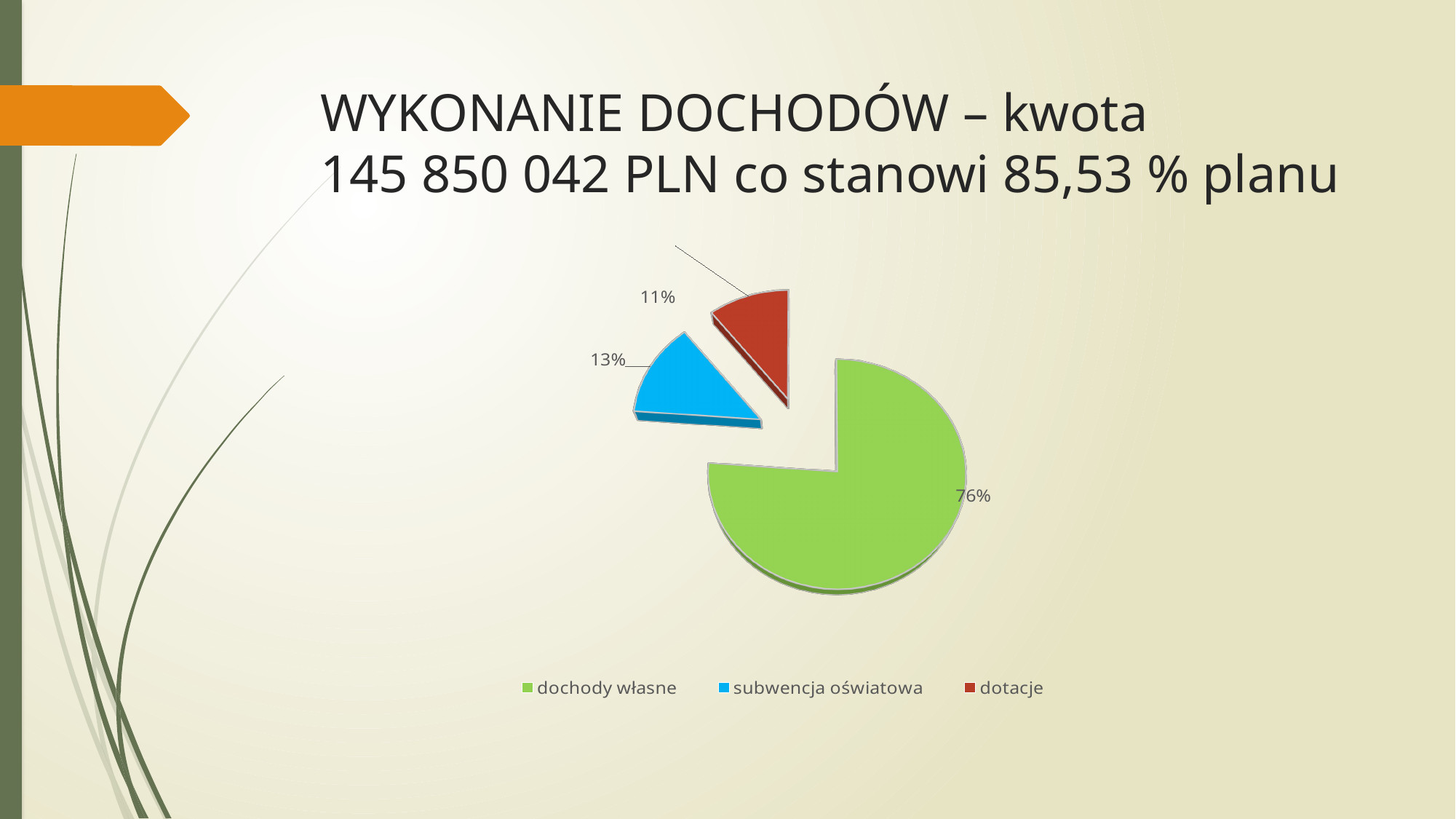
Which category has the largest slice of the pie? dochody własne How many entries does the legend list? 3 What share of the pie does dotacje represent? 11% What share of the pie does subwencja oświatowa represent? 13% Which category has the smallest slice of the pie? dotacje What is the difference in percentage points between dochody własne and subwencja oświatowa? 63 What colour is the slice for dochody własne? green What kind of chart is shown on the slide? pie chart How many slices does the pie chart have? 3 What share of the pie does dochody własne represent? 76% Which is larger, the share for subwencja oświatowa or the share for dotacje? subwencja oświatowa What is the difference in percentage points between subwencja oświatowa and dotacje? 2